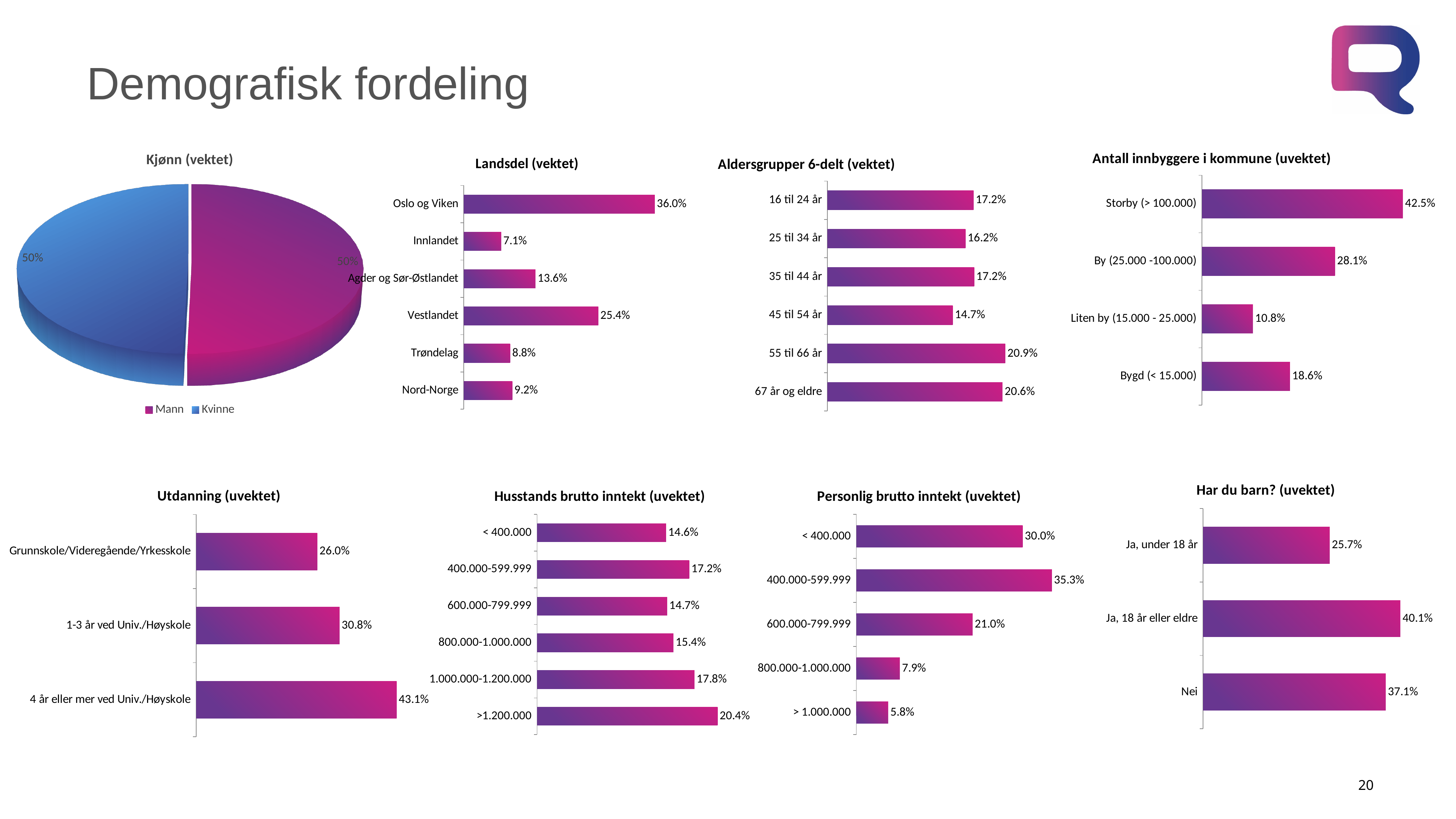
In the 'Husstands brutto inntekt (uvektet)' chart, which income bracket has the highest value? >1.200.000 In the 'Personlig brutto inntekt (uvektet)' chart, which is larger: < 400.000 or 400.000-599.999? 400.000-599.999 In the 'Aldersgrupper 6-delt (vektet)' chart, how many age groups are shown? 6 In the 'Landsdel (vektet)' chart, which category has the lowest value? Innlandet In the 'Antall innbyggere i kommune (uvektet)' chart, what is the difference between Storby (> 100.000) and By (25.000 -100.000)? 14.4% In the 'Antall innbyggere i kommune (uvektet)' chart, which category has the highest value? Storby (> 100.000) In the 'Aldersgrupper 6-delt (vektet)' chart, what is the value for 55 til 66 år? 20.9% What kind of chart is 'Kjønn (vektet)'? Pie chart In the 'Har du barn? (uvektet)' chart, what is the value for Nei? 37.1% In the 'Personlig brutto inntekt (uvektet)' chart, what is the value for > 1.000.000? 5.8% In the 'Utdanning (uvektet)' chart, what is the value for 4 år eller mer ved Univ./Høyskole? 43.1% In the 'Landsdel (vektet)' chart, what is the value for Oslo og Viken? 36.0%